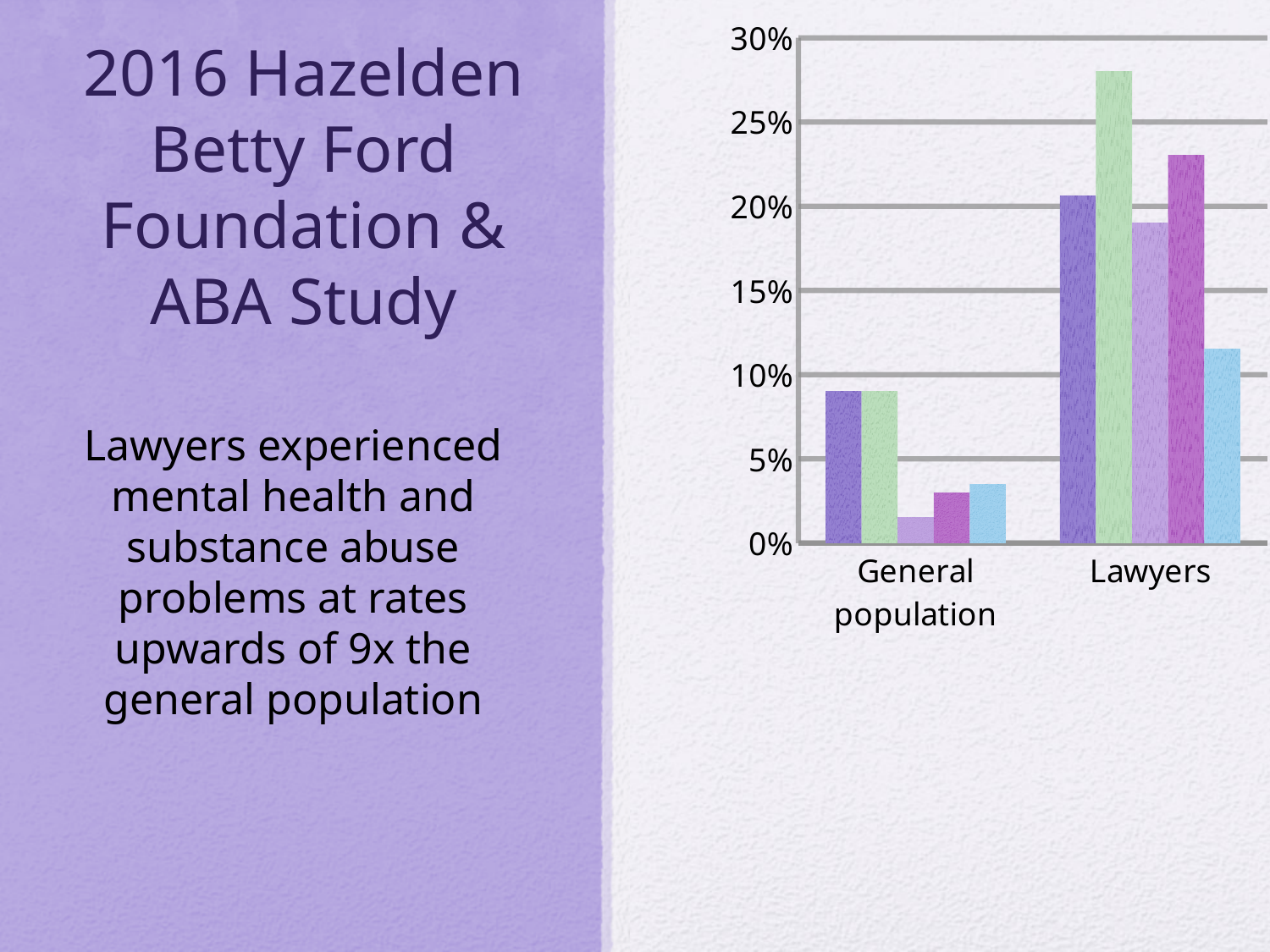
How many bars are plotted for each category in the chart? 5 Which coloured bar is the tallest within the Lawyers category? green Which category has the tallest bar in the chart? Lawyers Is the value of the light purple bar for General population greater or less than 5%? less What kind of chart is shown on the slide? bar chart How many categories are shown on the x axis of the chart? 2 Is the value of the magenta bar for Lawyers greater or less than 20%? greater Is the value of the green bar for Lawyers greater or less than 25%? greater Which is larger, the green bar for General population or the green bar for Lawyers? Lawyers What is the highest value shown on the y axis of the chart? 30%